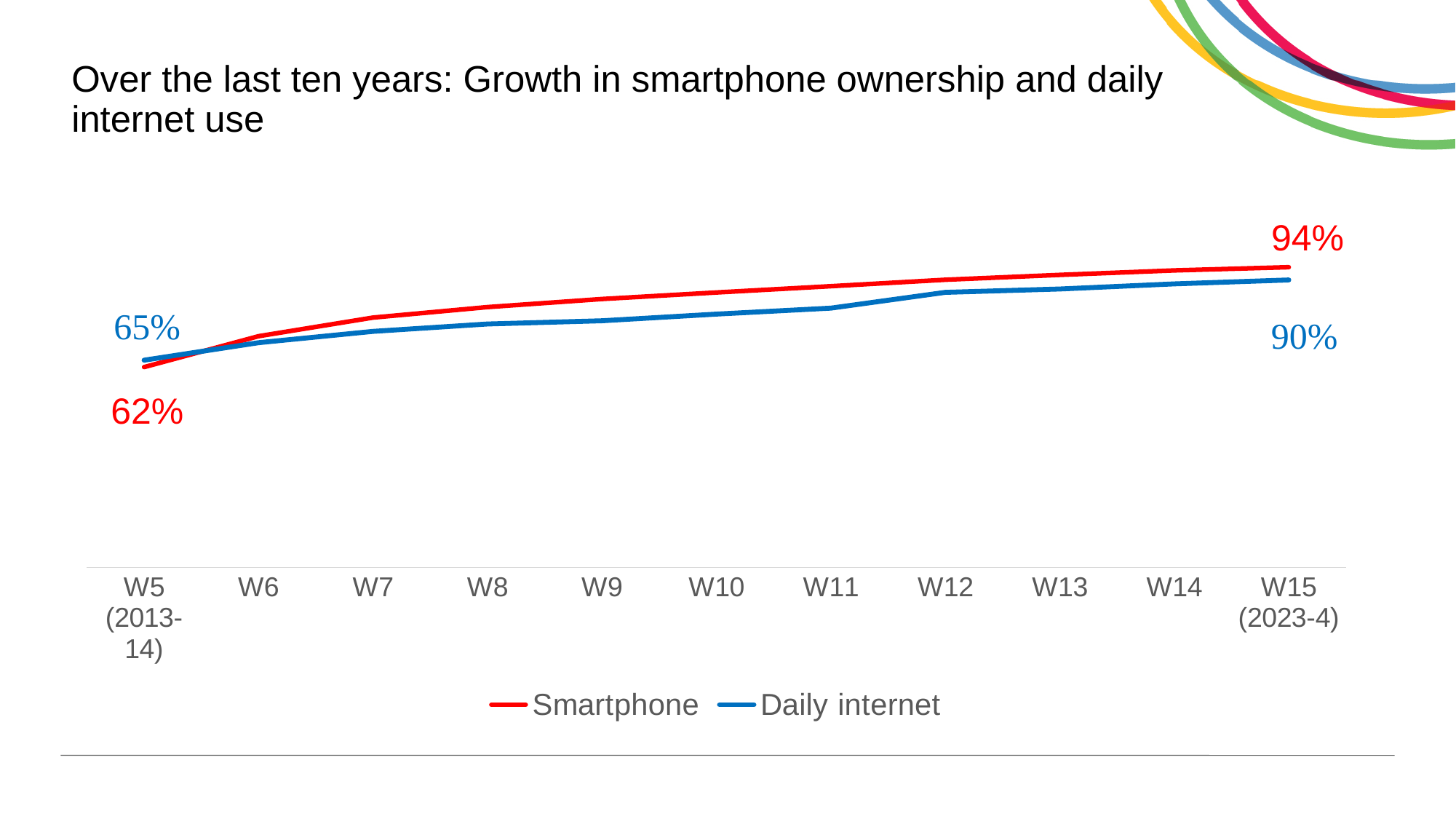
How many series does the legend list? 2 How many waves (categories) are shown on the x axis? 11 Do the Smartphone values rise or fall from W5 to W15? rise What is the Daily internet value at W5 (2013-14)? 65% By how many percentage points did the Smartphone value increase from W5 to W15? 32 What type of chart is shown on the slide? line chart What is the Daily internet value at W15 (2023-4)? 90% What is the Smartphone value at W15 (2023-4)? 94% By how many percentage points did the Daily internet value increase from W5 to W15? 25 What is the Smartphone value at W5 (2013-14)? 62% At W15 (2023-4), which series has the higher value, Smartphone or Daily internet? Smartphone At W5 (2013-14), which series has the higher value, Smartphone or Daily internet? Daily internet